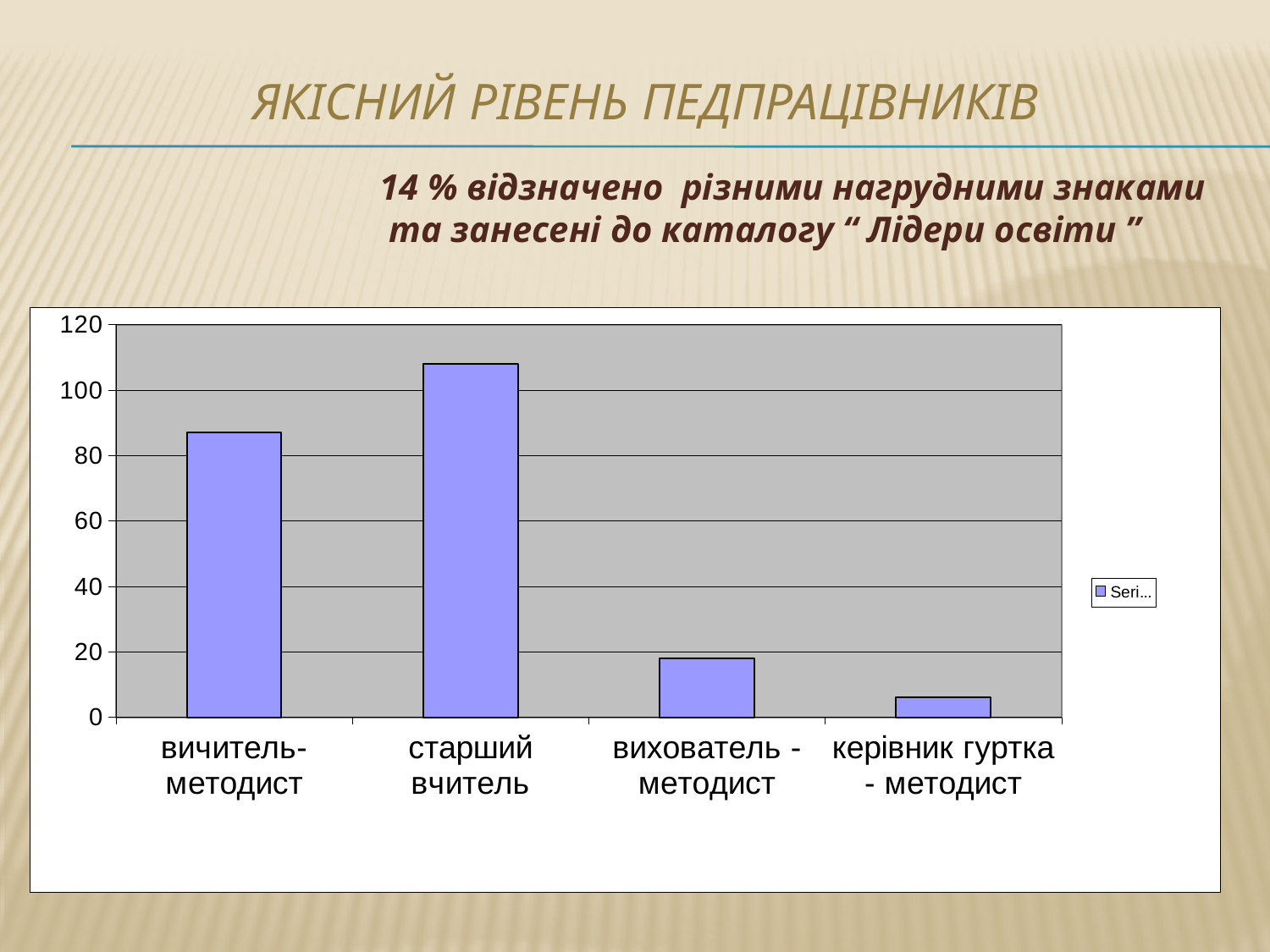
What is the maximum value shown on the vertical axis of the chart? 120 Is the value for старший вчитель greater or less than 100? greater How many series does the legend of the chart list? 1 Which category has the highest bar in the chart? старший вчитель Which is larger, the value for вичитель-методист or the value for вихователь - методист? вичитель-методист What kind of chart is shown on the slide? bar chart How many categories are shown on the x axis of the chart? 4 Is the value for вихователь - методист greater or less than 20? less Is the value for вичитель-методист greater or less than 80? greater Which is larger, the value for старший вчитель or the value for вичитель-методист? старший вчитель Which category has the lowest bar in the chart? керівник гуртка - методист